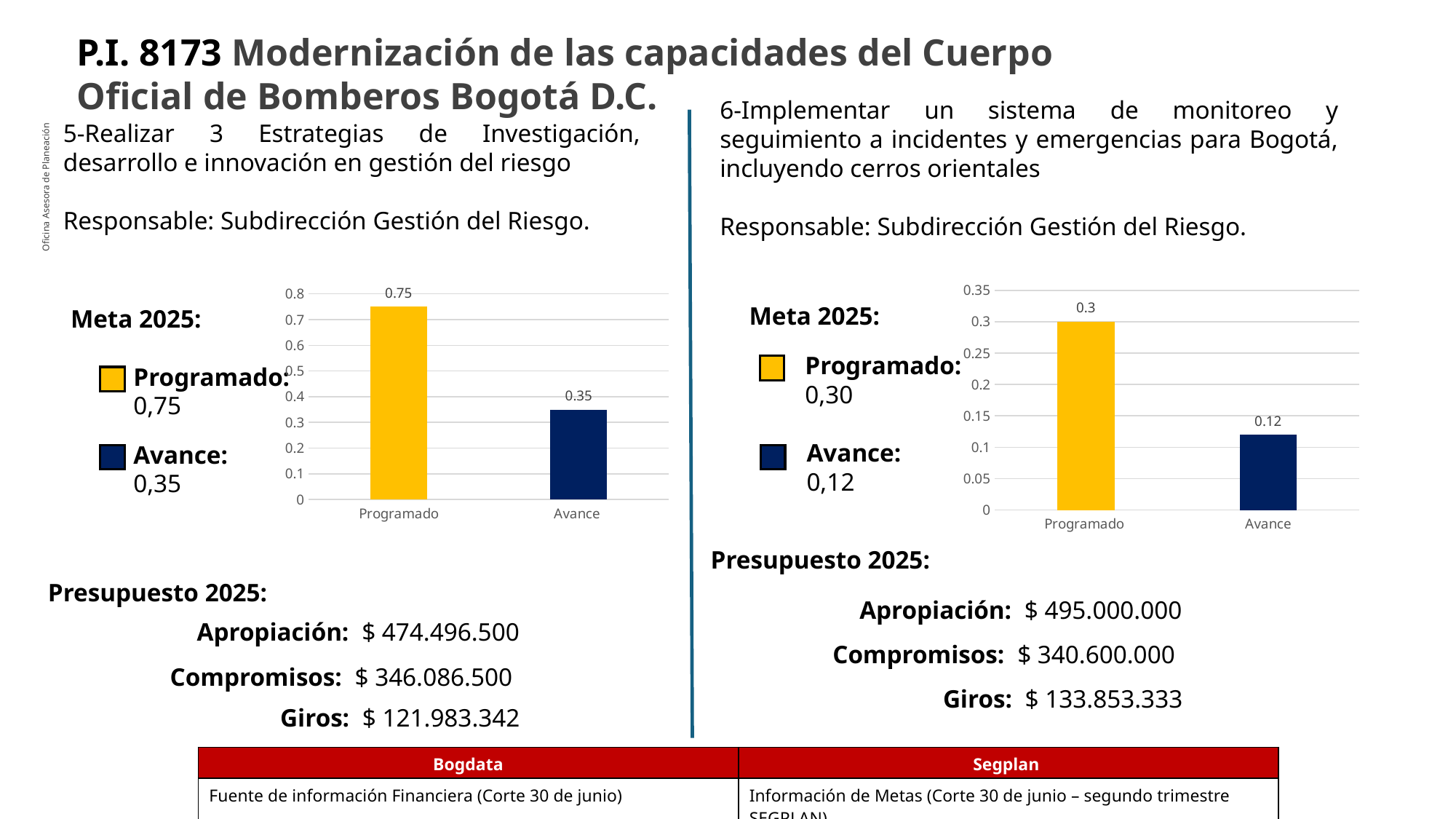
In the right chart, what is the value for Programado? 0.3 In the right chart, is the value for Programado greater or less than 0.25? greater In the left chart, what is the difference between Programado and Avance? 0.4 In the right chart, what is the difference between Programado and Avance? 0.18 In the right chart, which category has the lowest value? Avance In the left chart, what is the value for Avance? 0.35 In the left chart, what is the value for Programado? 0.75 In the left chart, what colour is the Programado bar? yellow What kind of chart is the right chart? bar chart In the left chart, which category has the highest value? Programado In the right chart, what is the value for Avance? 0.12 How many bars are shown in the left chart? 2